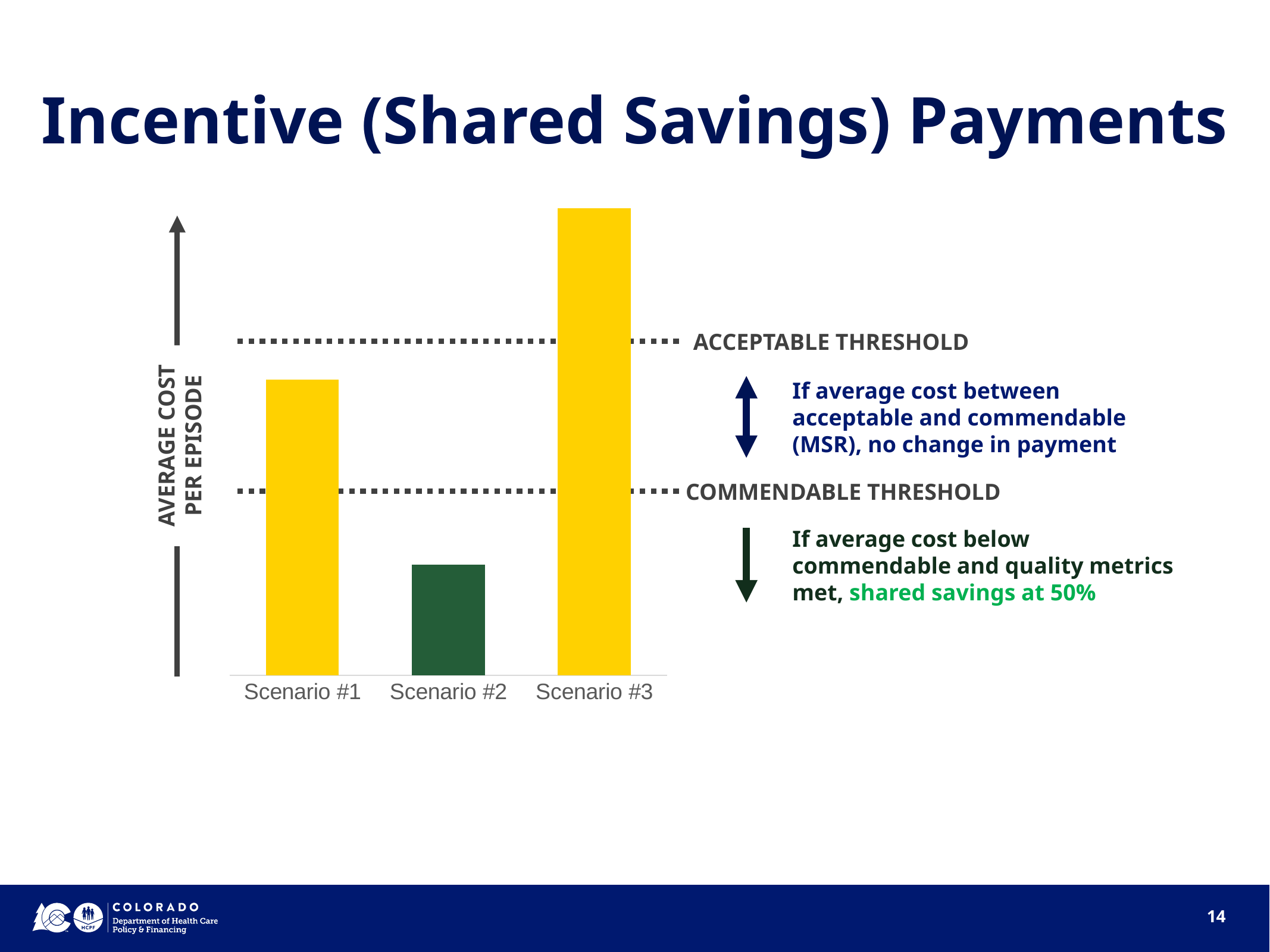
What kind of chart is shown on the slide? Bar chart How many scenarios are plotted on the chart? 3 What colour is the bar for Scenario #2? Green Which has a higher average cost per episode, Scenario #1 or Scenario #3? Scenario #3 Which has a higher average cost per episode, Scenario #1 or Scenario #2? Scenario #1 Which has a lower average cost per episode, Scenario #2 or Scenario #3? Scenario #2 Which scenario has the highest average cost per episode? Scenario #3 Which scenario has the lowest average cost per episode? Scenario #2 What is the label on the vertical axis of the chart? AVERAGE COST PER EPISODE